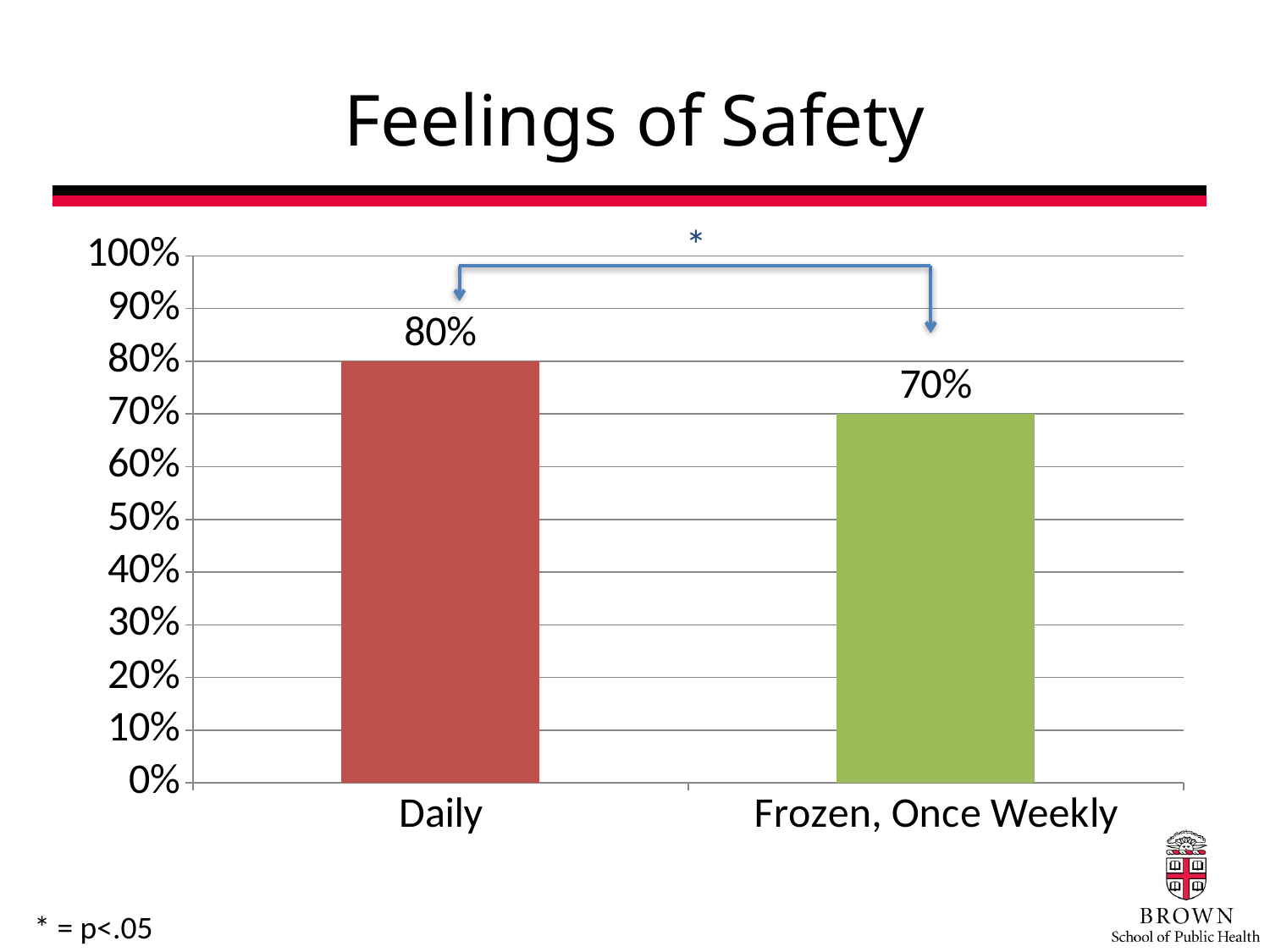
What does the asterisk on the chart indicate, according to the footnote? p<.05 What is the title of the slide? Feelings of Safety Is the value for Daily greater or less than 90%? less What is the value for Daily? 80% Which is larger, the value for Daily or the value for Frozen, Once Weekly? Daily Is the value for Frozen, Once Weekly greater or less than 50%? greater What is the difference between the values for Daily and Frozen, Once Weekly? 10% Which category has the lowest value? Frozen, Once Weekly How many categories are shown on the x axis? 2 What is the value for Frozen, Once Weekly? 70% What kind of chart is shown on the slide? bar chart Which category has the highest value? Daily